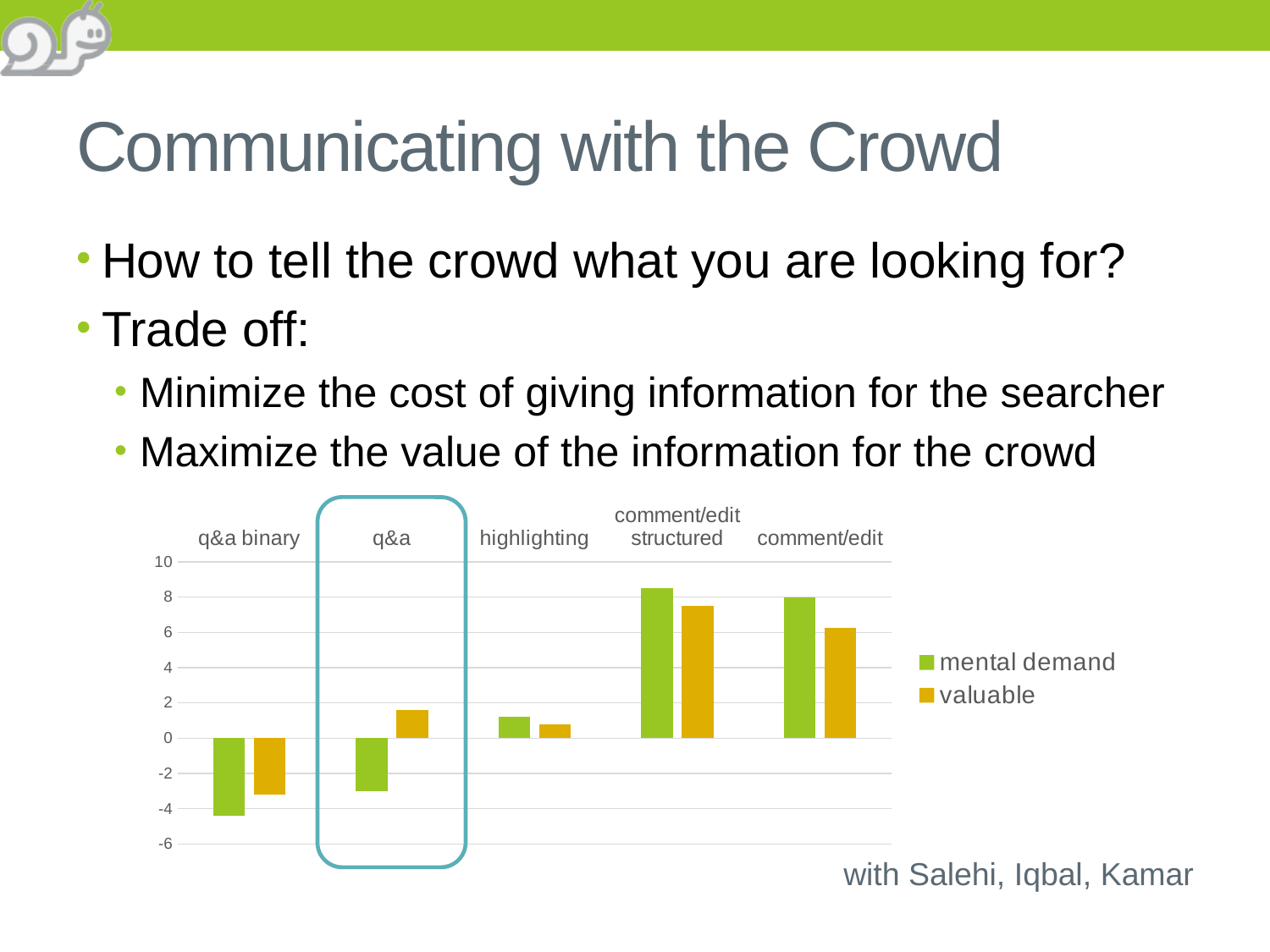
Which category has the lowest mental demand value? q&a binary How many categories are shown along the x axis of the chart? 5 For comment/edit, which is larger: the mental demand value or the valuable value? mental demand What kind of chart is shown on the slide? bar chart Which category has the lowest valuable value? q&a binary Which category has the highest mental demand value? comment/edit structured How many series does the chart's legend list? 2 Which series is shown in green in the chart? mental demand Is the valuable value for q&a greater or less than 2? less Is the mental demand value for q&a binary greater or less than -4? less Which is larger: the valuable value for comment/edit structured or the valuable value for highlighting? comment/edit structured Is the mental demand value for comment/edit structured greater or less than 8? greater